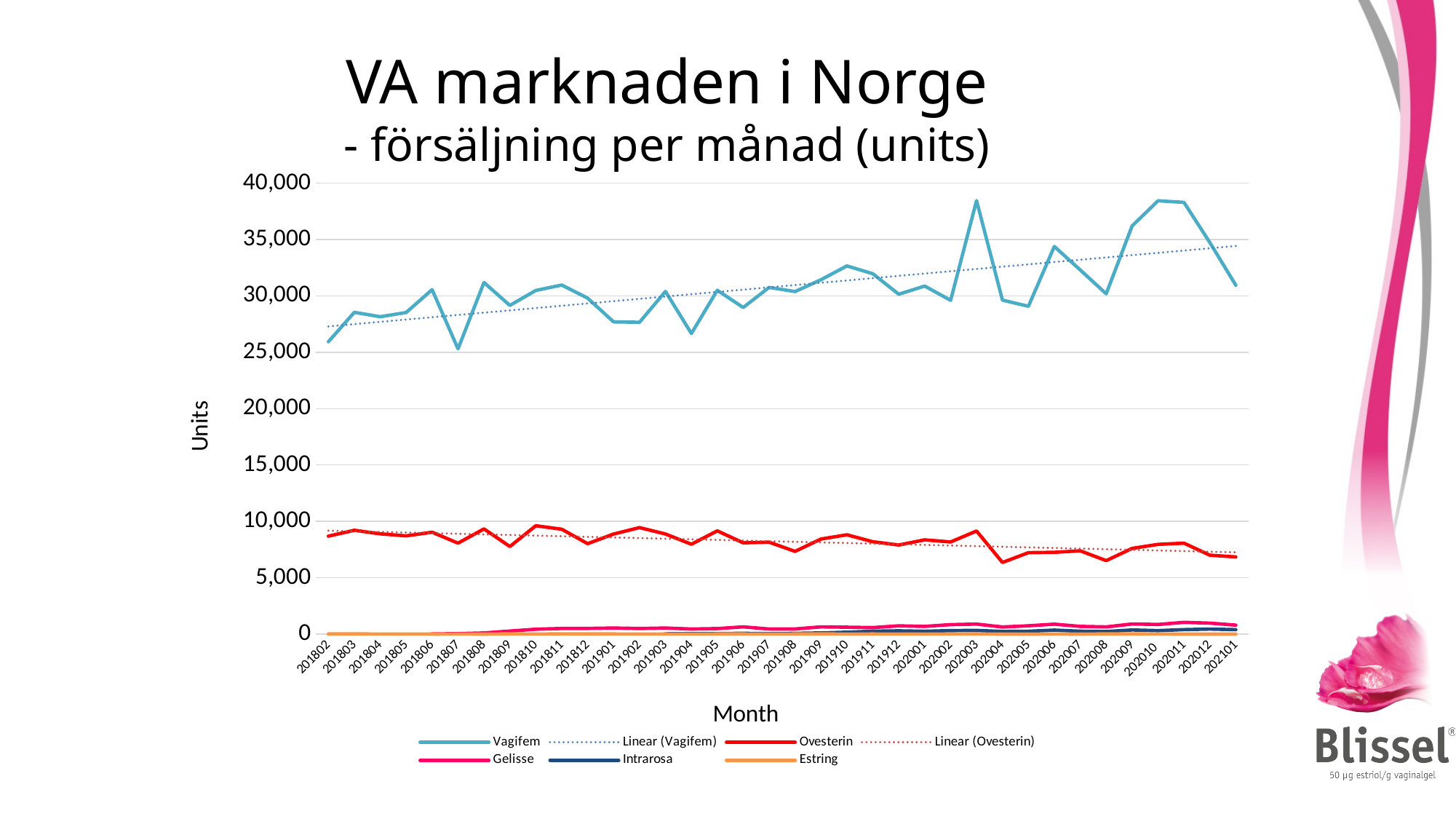
Which is larger in 202010, the value for Vagifem or the value for Ovesterin? Vagifem Is the value for Ovesterin in 202004 greater or less than 5,000? greater What kind of chart is shown on the slide? line chart What is the label on the vertical axis of the chart? Units Which series has the highest values throughout the chart? Vagifem How many months are plotted along the x axis? 36 Does the Linear (Ovesterin) trend line rise or fall from left to right? fall Is the value for Vagifem in 201807 greater or less than 30,000? less Does the Linear (Vagifem) trend line rise or fall from left to right? rise Is the value for Vagifem in 202003 greater or less than 35,000? greater How many entries does the legend list? 7